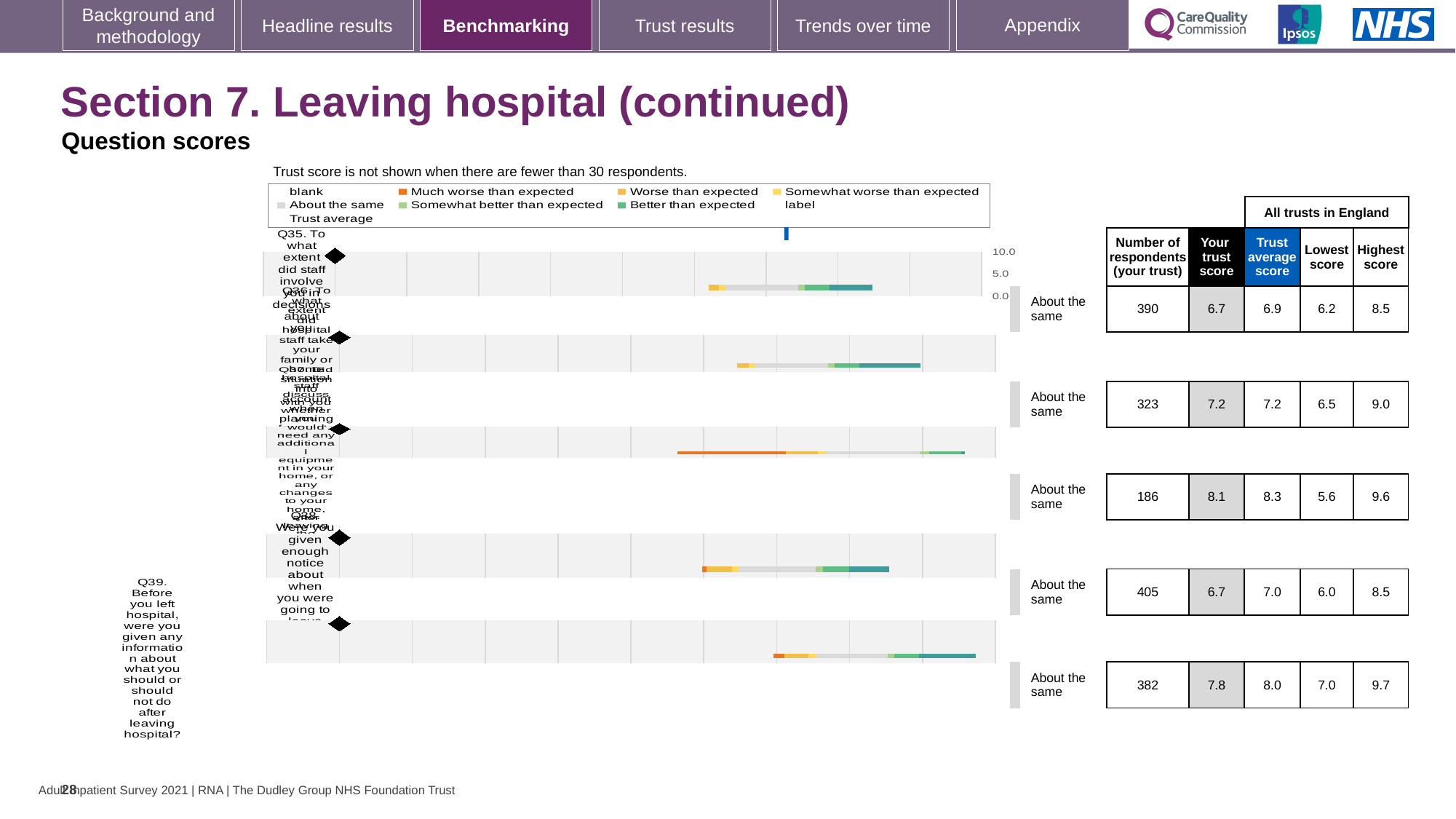
How many question rows are shown in the chart? 5 What is the trust average score for Q39 (information about what you should or should not do after leaving hospital)? 8.0 What is the trust score for the first question row (Q35)? 6.7 What is the trust score for Q39 (information about what you should or should not do after leaving hospital)? 7.8 Is the trust score for Q39 larger or smaller than the trust average score for Q39? smaller What is the highest score across all trusts in England for Q39? 9.7 What is the number of respondents for Q39 (information about what you should or should not do after leaving hospital)? 382 What is the lowest score across all trusts in England for Q39? 7.0 What is the difference between the highest score and the lowest score for Q39? 2.7 What is the number of respondents for the first question row (Q35)? 390 Which question row has the highest number of respondents? The fourth row (Q38), with 405 Which question row has the lowest number of respondents? The third row (Q37), with 186